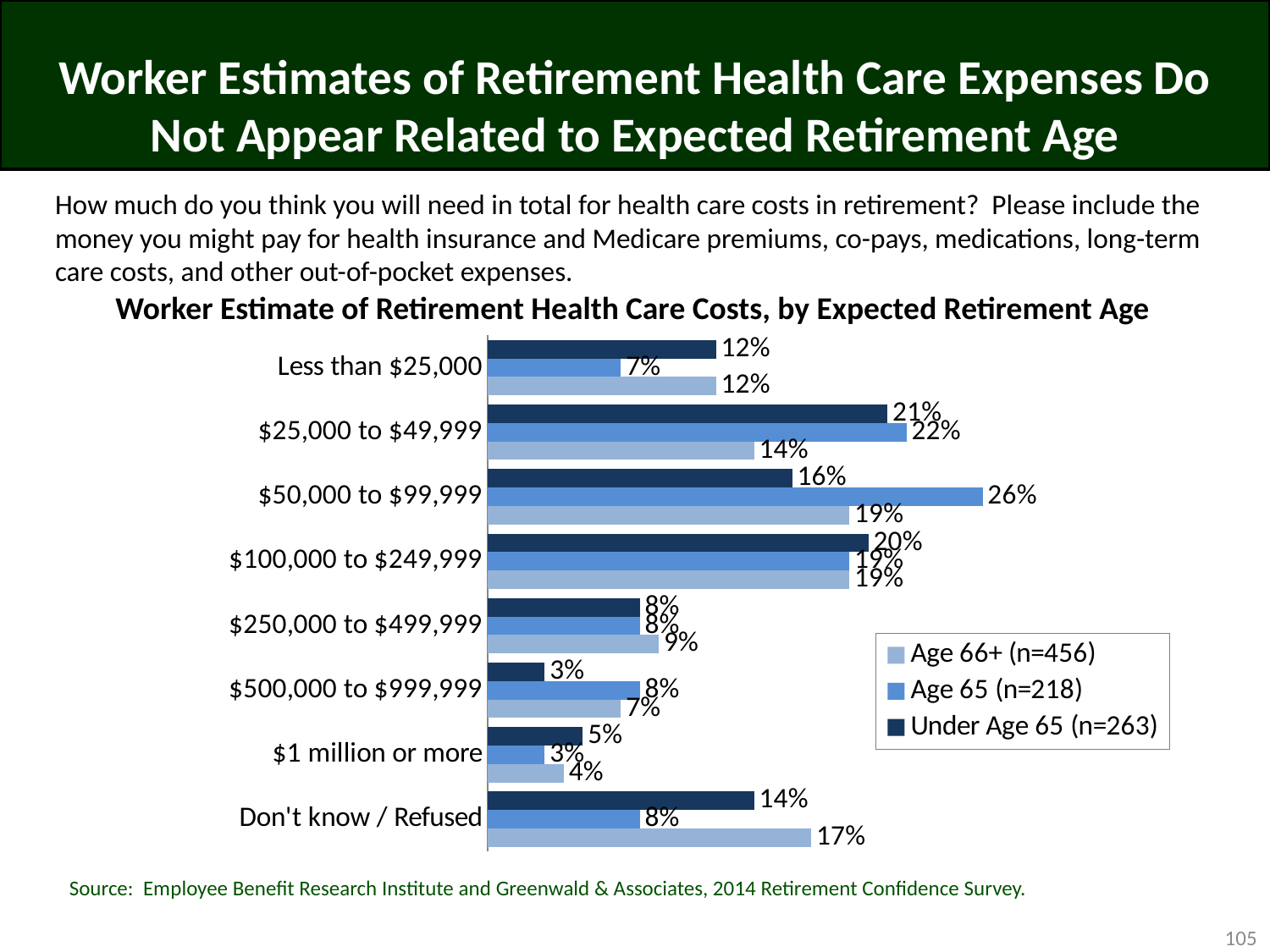
What type of chart is shown on the slide? Bar chart What is the value for Age 65 (n=218) in the Less than $25,000 category? 7% What is the value for Under Age 65 (n=263) in the Don't know / Refused category? 14% How many series does the legend list? 3 In the Don't know / Refused category, which is larger: the value for Age 66+ (n=456) or for Age 65 (n=218)? Age 66+ (n=456) How many cost categories are shown on the chart? 8 What is the value for Age 66+ (n=456) in the $25,000 to $49,999 category? 14% Which category has the lowest value for Under Age 65 (n=263)? $500,000 to $999,999 What is the value for Age 65 (n=218) in the $50,000 to $99,999 category? 26% What is the title of the chart? Worker Estimate of Retirement Health Care Costs, by Expected Retirement Age Which category has the highest value for Age 66+ (n=456)? $50,000 to $99,999 and $100,000 to $249,999 (tied at 19%) What is the difference between the Age 65 (n=218) and Under Age 65 (n=263) values in the $50,000 to $99,999 category? 10%